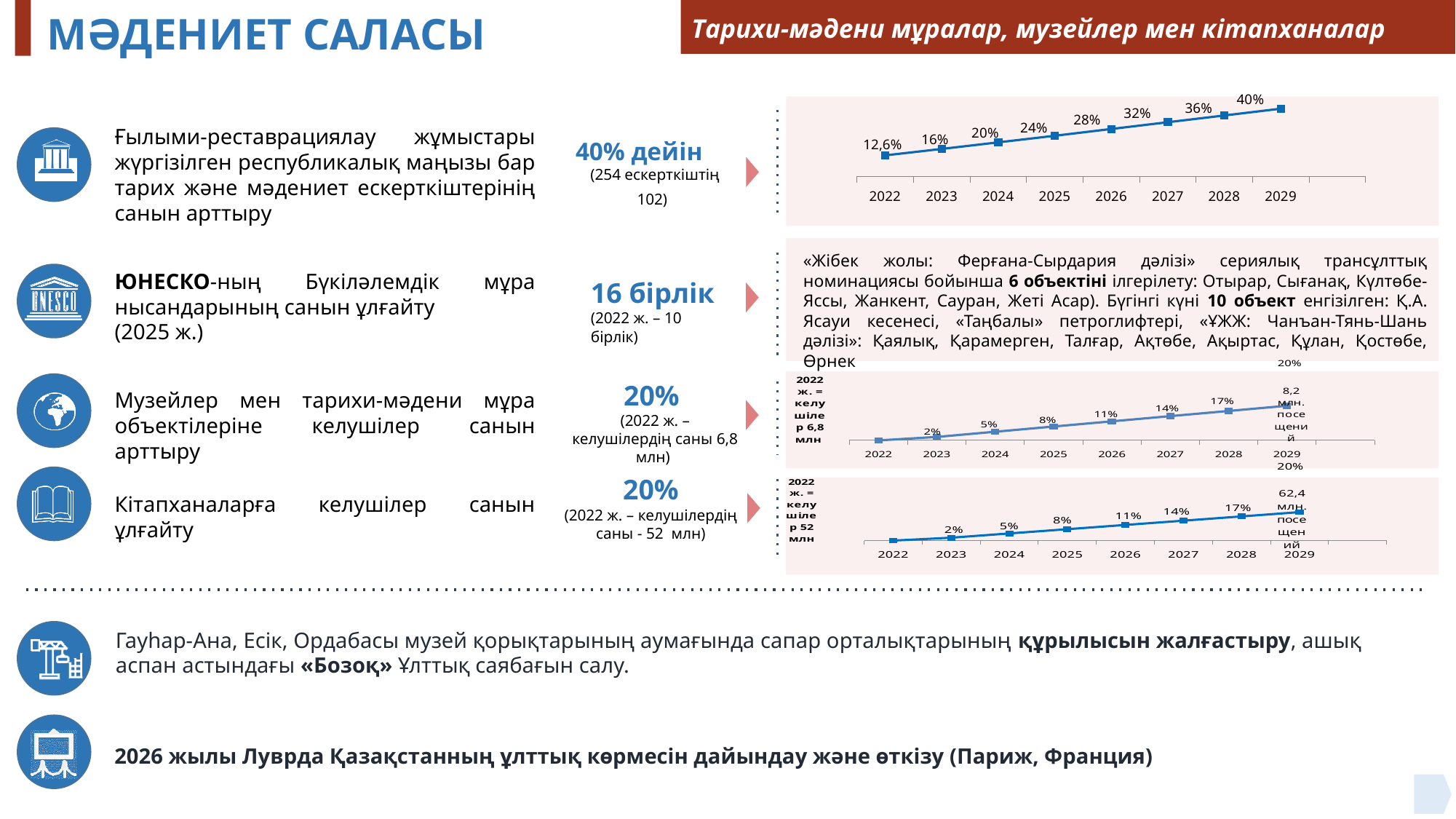
In the top chart on the right side of the slide, what is the value for 2029? 40% In the top chart on the right side of the slide, how many years are plotted on the x axis? 8 In the middle chart on the right side of the slide (museum visitors), what is the value for 2026? 11% In the bottom chart on the right side of the slide (library visitors), which is larger, the value for 2027 or the value for 2025? 2027 In the top chart on the right side of the slide, which year has the lowest value? 2022 What kind of chart is the top chart on the right side of the slide? Line chart In the middle chart on the right side of the slide (museum visitors), what is the value for 2029? 20% In the top chart on the right side of the slide, do the values rise or fall from 2022 to 2029? Rise In the top chart on the right side of the slide, what is the difference between the values for 2029 and 2025? 16% In the top chart on the right side of the slide, which year has the highest value? 2029 In the bottom chart on the right side of the slide (library visitors), what is the value for 2024? 5% In the top chart on the right side of the slide, what is the value for 2022? 12,6%